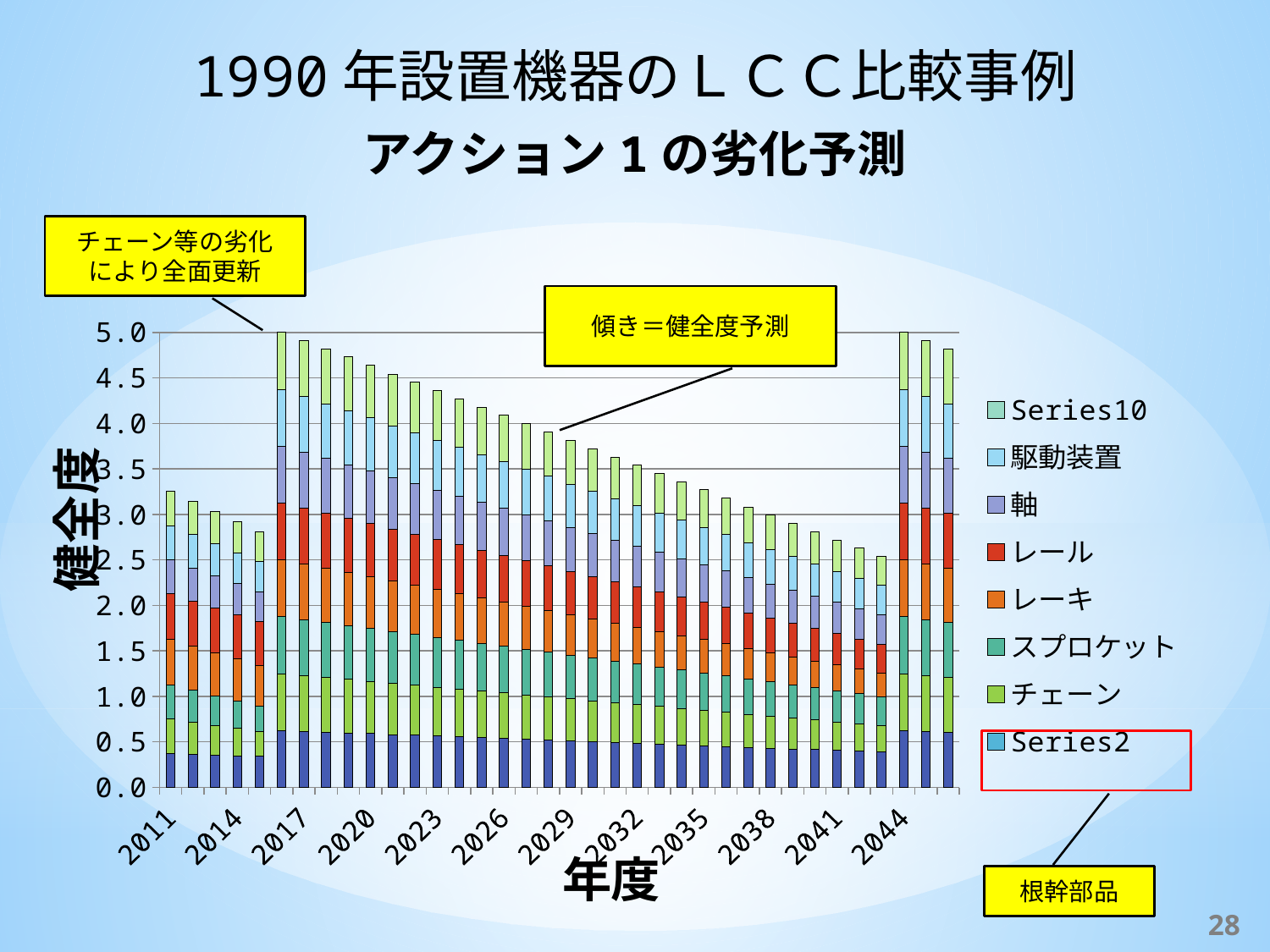
Is the total stacked value for 2041 greater or less than 3.0? less Which year has the larger total stacked value, 2017 or 2044? 2044 Which year has the lowest total stacked value? 2043 Is the total stacked value for 2017 greater or less than 4.5? greater What kind of chart is shown on the slide? stacked bar chart Is the total stacked value for 2044 greater or less than 3.0? greater How many series does the legend list? 8 What is the title of the vertical axis? 健全度 Which legend entry is outlined with a red box? Series2